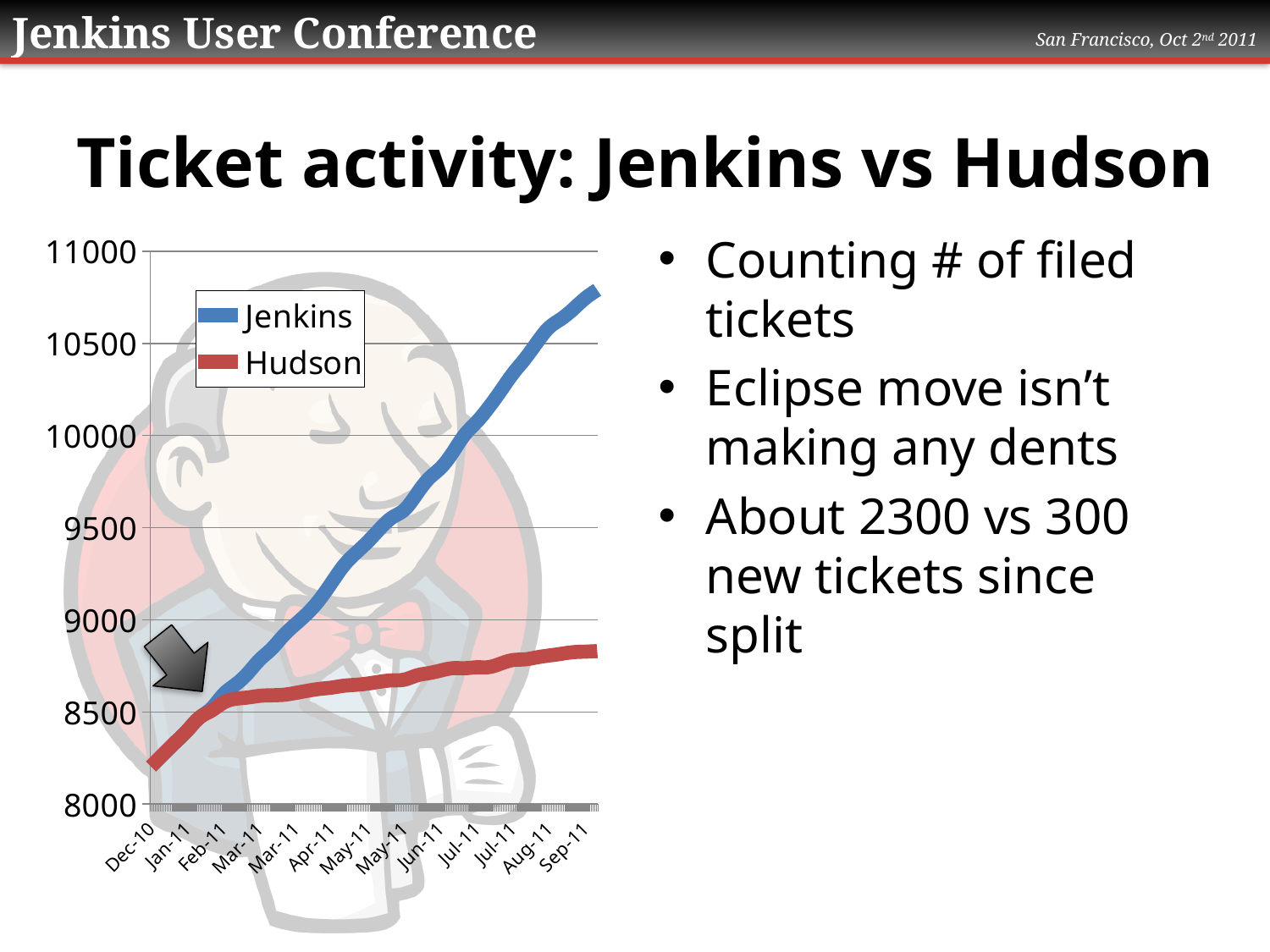
Which series reaches the highest value on the chart? Jenkins Does the Hudson line rise or fall from Dec-10 to Sep-11? rise What colour is the Jenkins line in the chart? blue Which two series are listed in the chart legend? Jenkins and Hudson What kind of chart is shown on the slide? line chart How many date labels are shown along the x axis of the chart? 13 Is the value for Hudson at Dec-10 greater or less than 8500? less At Sep-11, which series has the higher value, Jenkins or Hudson? Jenkins Is the value for Jenkins at Sep-11 greater or less than 10500? greater How many series does the chart legend list? 2 Is the value for Hudson at Sep-11 greater or less than 9000? less Does the Jenkins line rise or fall from Dec-10 to Sep-11? rise